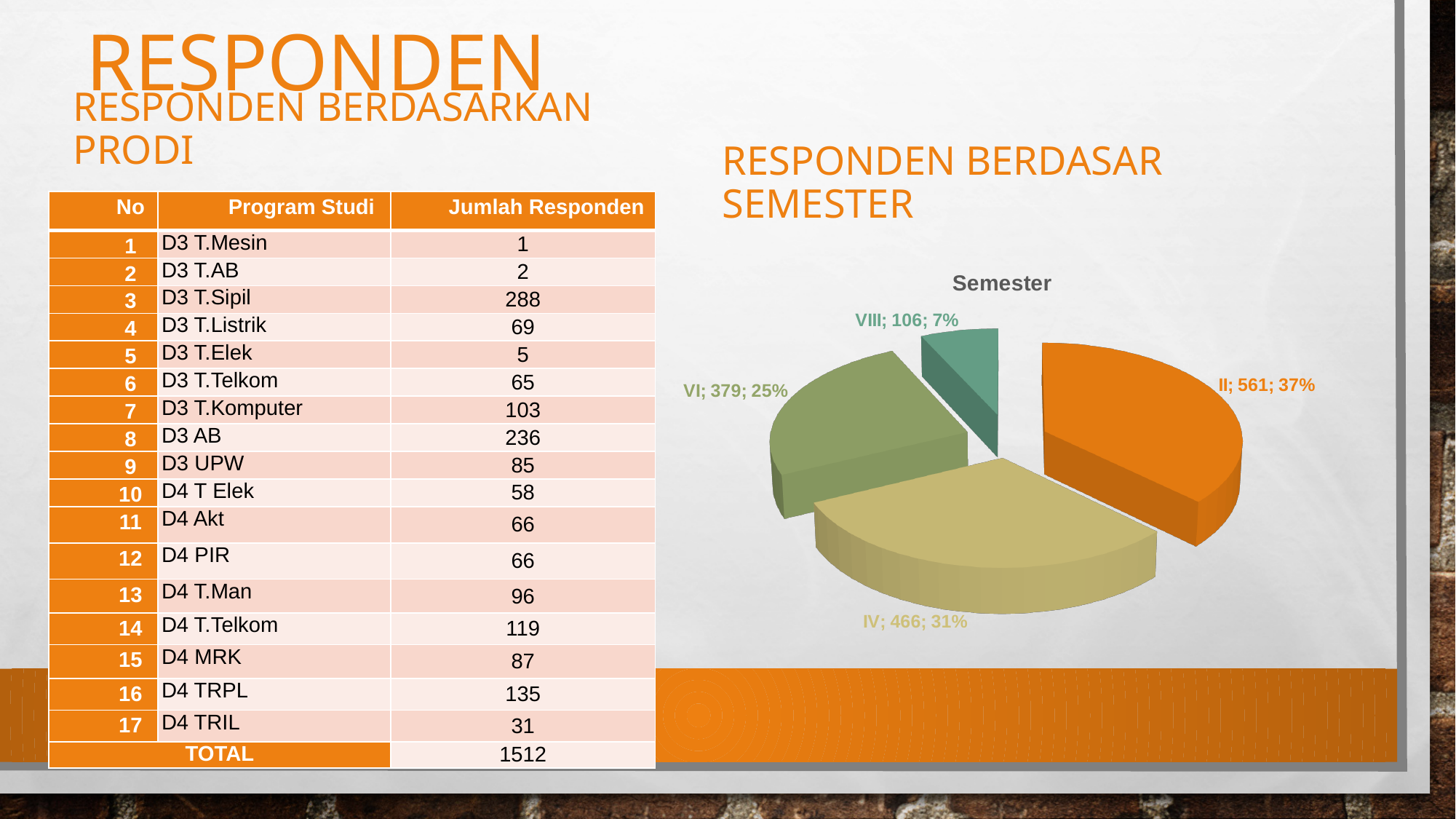
In the pie chart, which has more respondents, semester VI or semester VIII? VI In the pie chart, what is the difference in respondents between semester II and semester IV? 95 In the pie chart, how many respondents are in semester IV? 466 What is the title of the pie chart? Semester Which semester has the largest slice in the pie chart? II In the pie chart, how many respondents are in semester VI? 379 In the pie chart, how many respondents are in semester II? 561 How many slices does the pie chart have? 4 What kind of chart is shown under the heading "Responden Berdasar Semester"? pie chart In the pie chart, how many respondents are in semester VIII? 106 Which semester has the smallest slice in the pie chart? VIII What share of the pie chart does semester VI represent? 25%